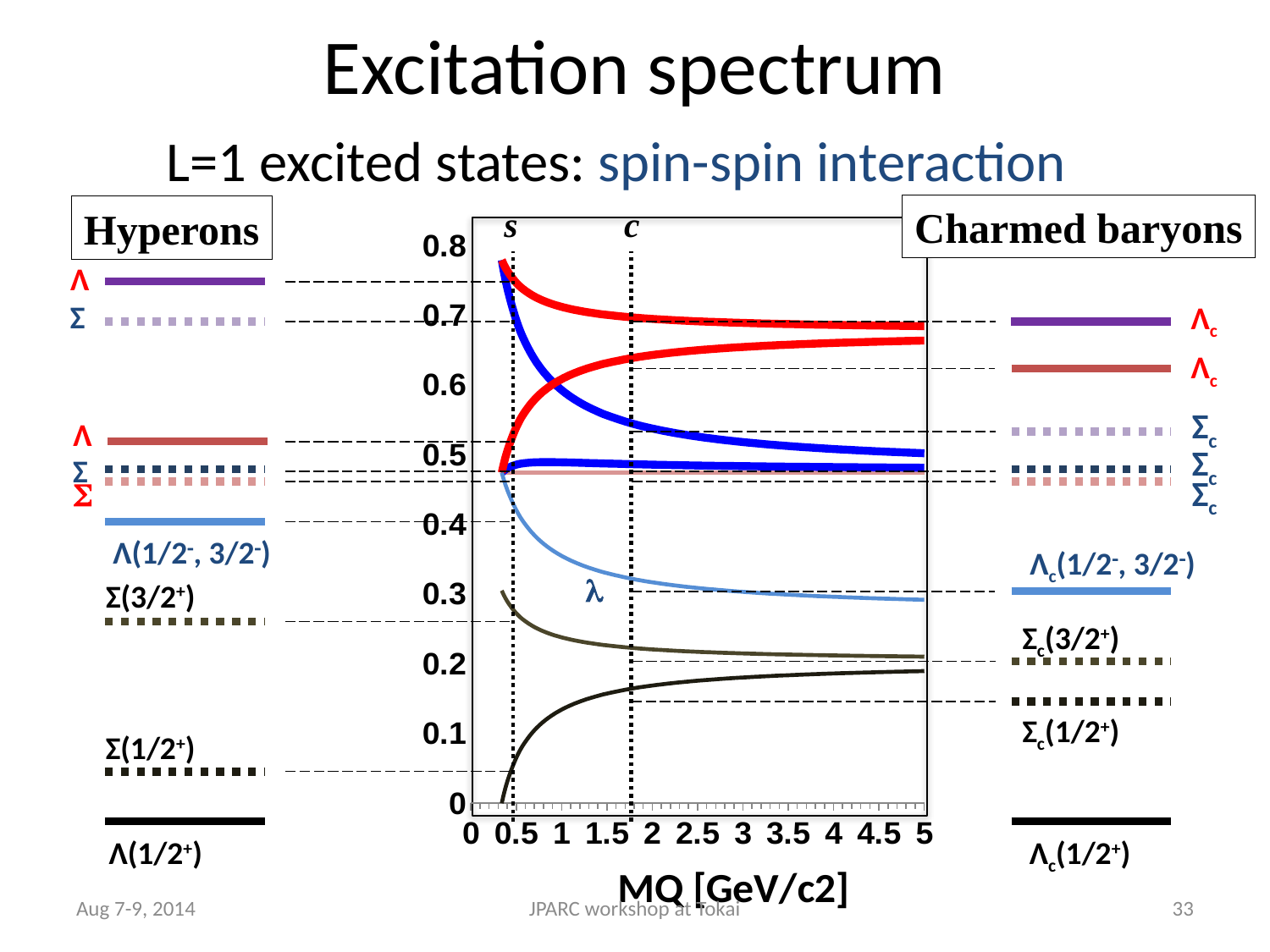
Does the light blue curve labelled λ rise or fall as MQ increases? fall Does the lowest dark curve rise or fall as MQ increases? rise What is the x-axis label of the chart? MQ [GeV/c2] How many tick labels are printed along the x-axis of the chart? 11 At MQ = 5, is the value of the upper thick red curve greater or less than 0.6? greater At MQ = 5, is the value of the light blue λ curve greater or less than 0.4? less What is the largest value shown on the x-axis of the chart? 5 What is the highest value shown on the y-axis of the chart? 0.8 At MQ = 5, is the value of the lowest dark curve greater or less than 0.1? greater What kind of chart is shown in the centre of the slide? line chart Does the upper thick red curve rise or fall as MQ increases? fall What are the labels of the two vertical dotted lines on the chart? s and c